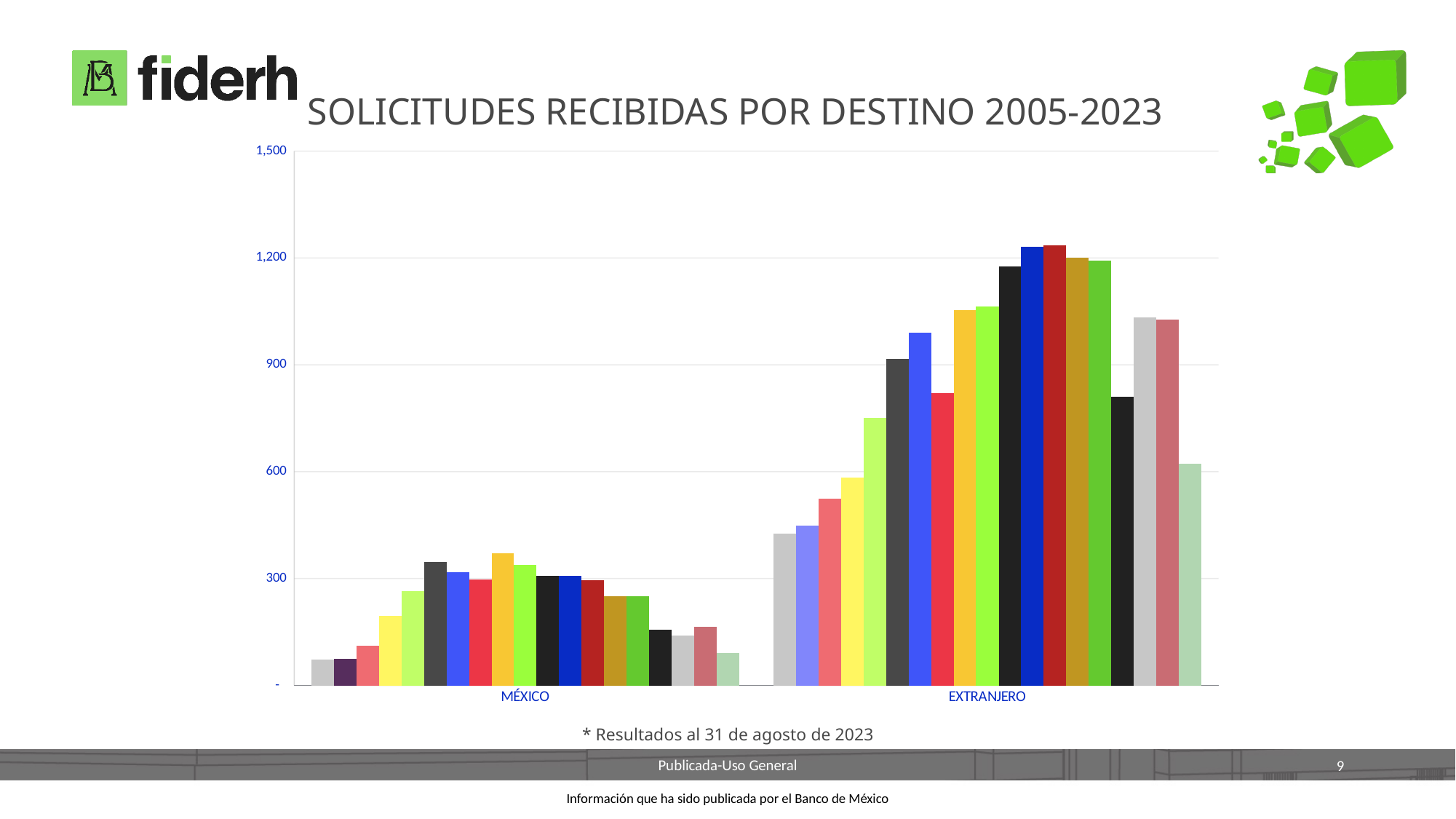
How many categories are shown on the x axis of the chart? 2 Which category contains the tallest bar in the chart, MÉXICO or EXTRANJERO? EXTRANJERO What is the title of the chart? SOLICITUDES RECIBIDAS POR DESTINO 2005-2023 What kind of chart is shown on the slide? bar chart Is the tallest bar in the EXTRANJERO category greater or less than 900? greater How many bars are plotted for the MÉXICO category? 19 Are all the bars in the MÉXICO category below 600? yes What is the highest value shown on the vertical axis of the chart? 1,500 Is the shortest bar in the EXTRANJERO category greater or less than 300? greater What are the two categories on the x axis of the chart? MÉXICO and EXTRANJERO